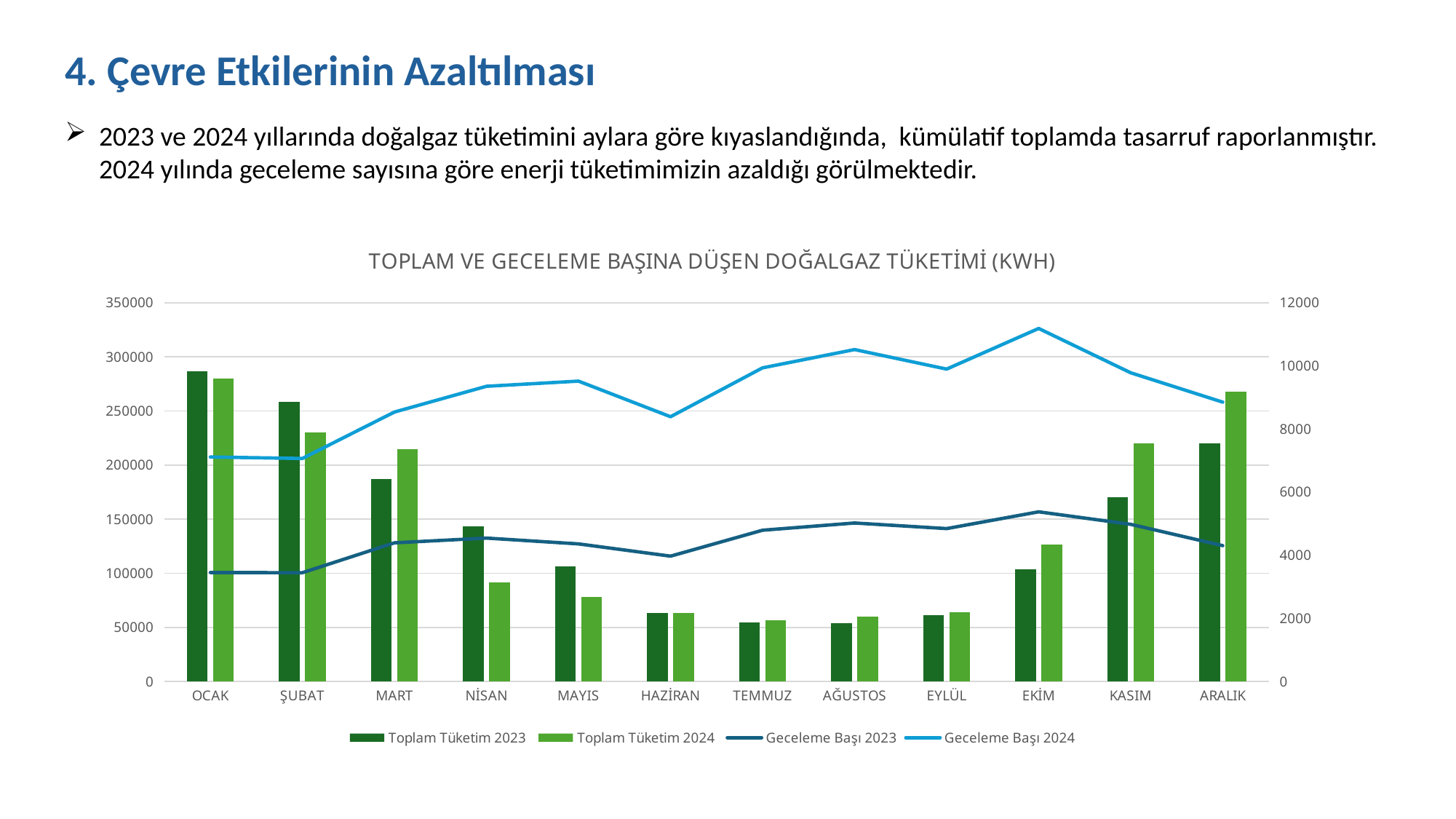
Does the Toplam Tüketim 2023 series rise or fall from OCAK to TEMMUZ? fall In NİSAN, which is larger: Toplam Tüketim 2023 or Toplam Tüketim 2024? Toplam Tüketim 2023 Which month has the highest Toplam Tüketim 2023 bar? OCAK What kind of chart is shown on the slide? A combined bar and line chart Which month has the highest Toplam Tüketim 2024 bar? OCAK Is the Toplam Tüketim 2024 value for MAYIS greater or less than 100000? less Which month has the highest Geceleme Başı 2024 value? EKİM In MART, which is larger: Toplam Tüketim 2023 or Toplam Tüketim 2024? Toplam Tüketim 2024 How many months are shown on the x axis? 12 Is the Toplam Tüketim 2023 value for OCAK greater or less than 250000? greater What is the title of the chart? TOPLAM VE GECELEME BAŞINA DÜŞEN DOĞALGAZ TÜKETİMİ (KWH) How many series does the legend list? 4